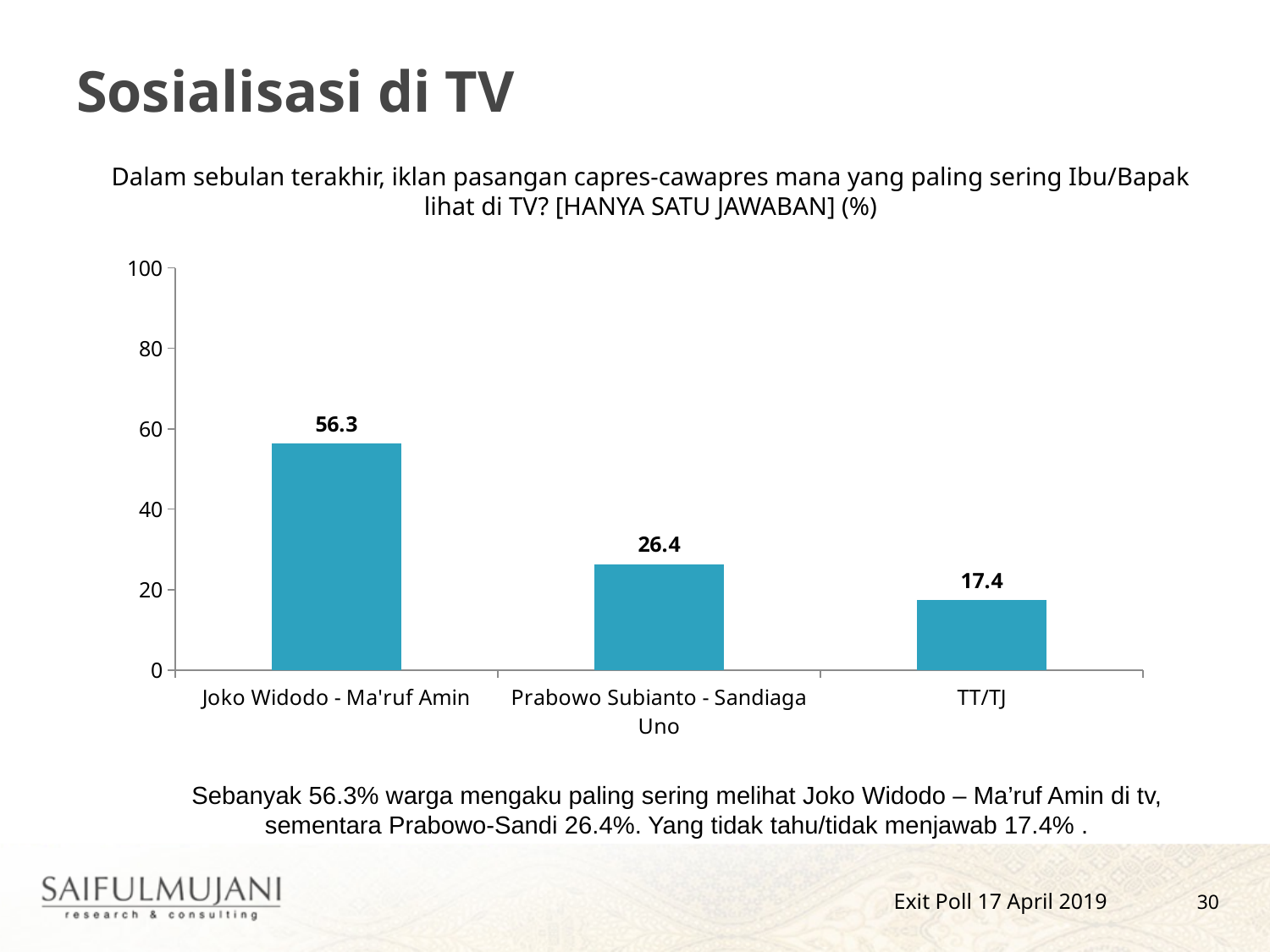
Is the value for Joko Widodo - Ma'ruf Amin greater or less than 60? less What is the value for TT/TJ? 17.4 Which is larger, the value for Prabowo Subianto - Sandiaga Uno or the value for TT/TJ? Prabowo Subianto - Sandiaga Uno What is the difference between the values for Prabowo Subianto - Sandiaga Uno and TT/TJ? 9.0 What kind of chart is shown on the slide? bar chart What is the value for Joko Widodo - Ma'ruf Amin? 56.3 What is the value for Prabowo Subianto - Sandiaga Uno? 26.4 Which category has the lowest value? TT/TJ What is the difference between the values for Joko Widodo - Ma'ruf Amin and Prabowo Subianto - Sandiaga Uno? 29.9 Do the values rise or fall from left to right along the x axis? fall How many categories are shown on the x axis? 3 Which category has the highest value? Joko Widodo - Ma'ruf Amin